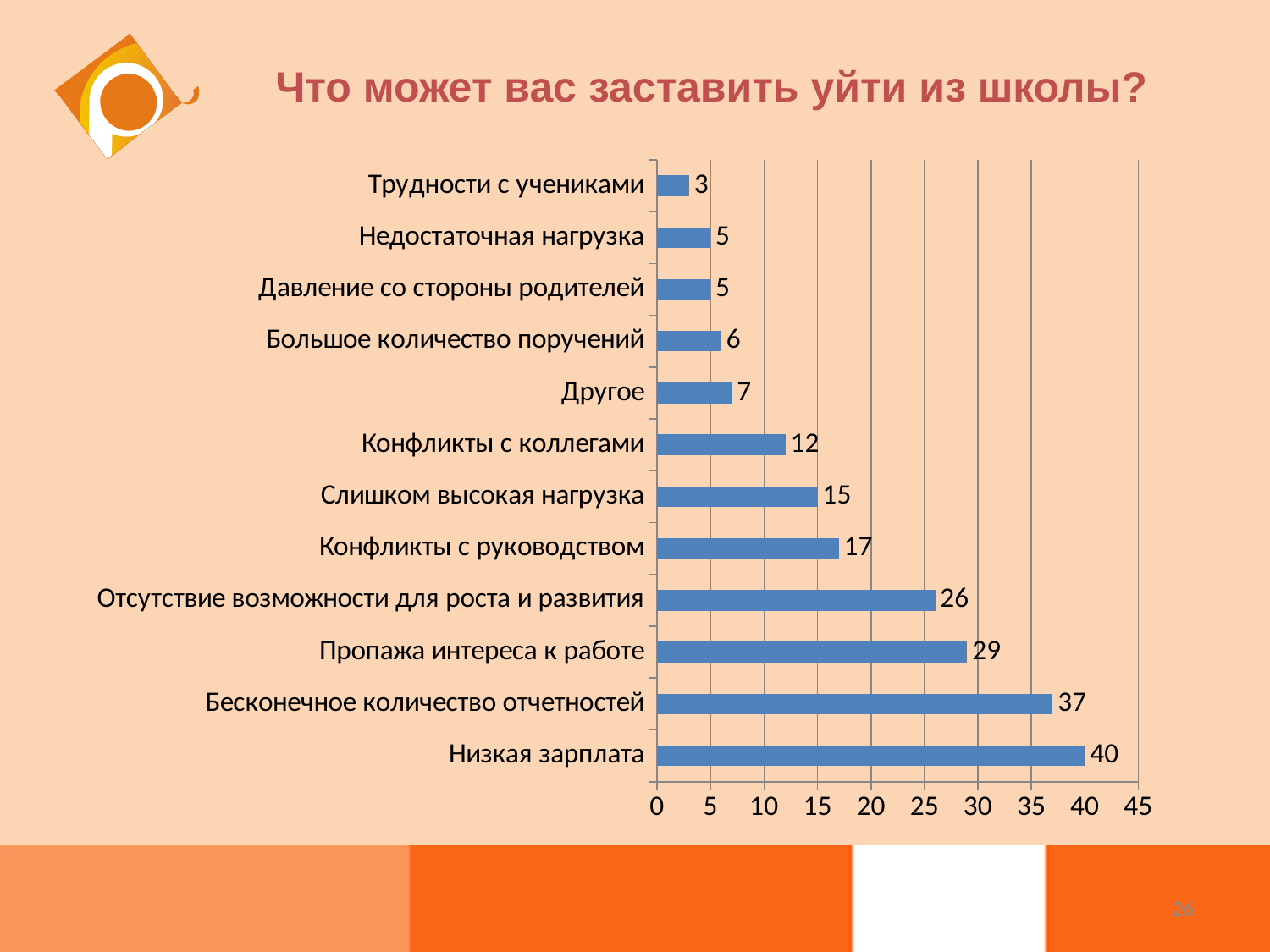
How many categories are shown in the chart? 12 Which category has the highest value? Низкая зарплата What is the value for «Конфликты с коллегами»? 12 Which category has the lowest value? Трудности с учениками What is the difference between «Низкая зарплата» and «Бесконечное количество отчетностей»? 3 What is the difference between «Пропажа интереса к работе» and «Конфликты с руководством»? 12 Which is larger: «Слишком высокая нагрузка» or «Другое»? Слишком высокая нагрузка Is the value for «Пропажа интереса к работе» greater or less than 25? greater What kind of chart is shown on the slide? bar chart What is the title of the slide? Что может вас заставить уйти из школы? What is the value for «Отсутствие возможности для роста и развития»? 26 What is the value for «Низкая зарплата»? 40